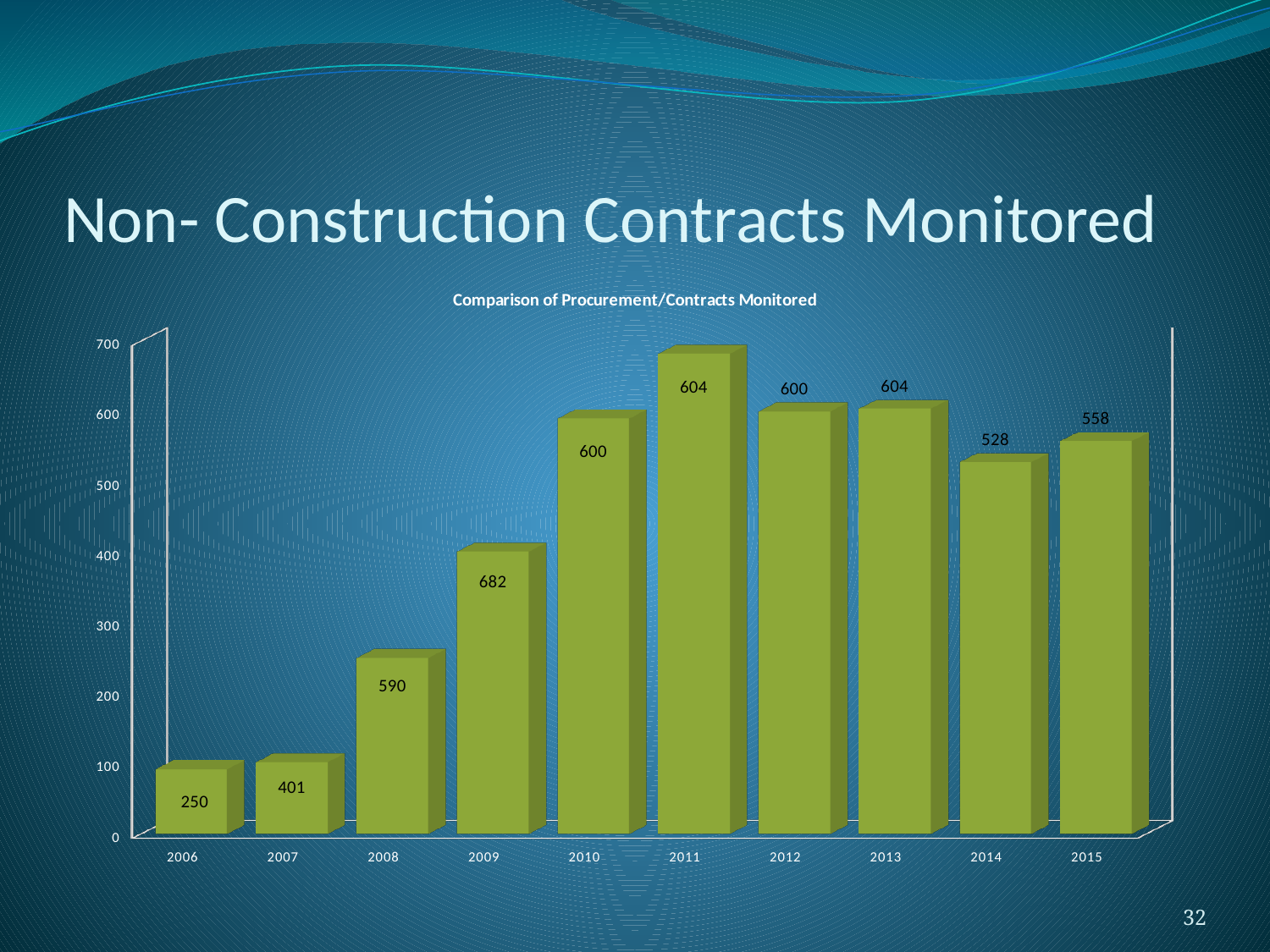
What is the value for 2014? 528 How many years are shown on the x axis? 10 Which is larger, the value for 2014 or the value for 2015? 2015 What is the difference between the values for 2015 and 2014? 30 Which year has the lowest value? 2006 What is the value for 2015? 558 What is the title of the chart? Comparison of Procurement/Contracts Monitored What kind of chart is shown? bar chart